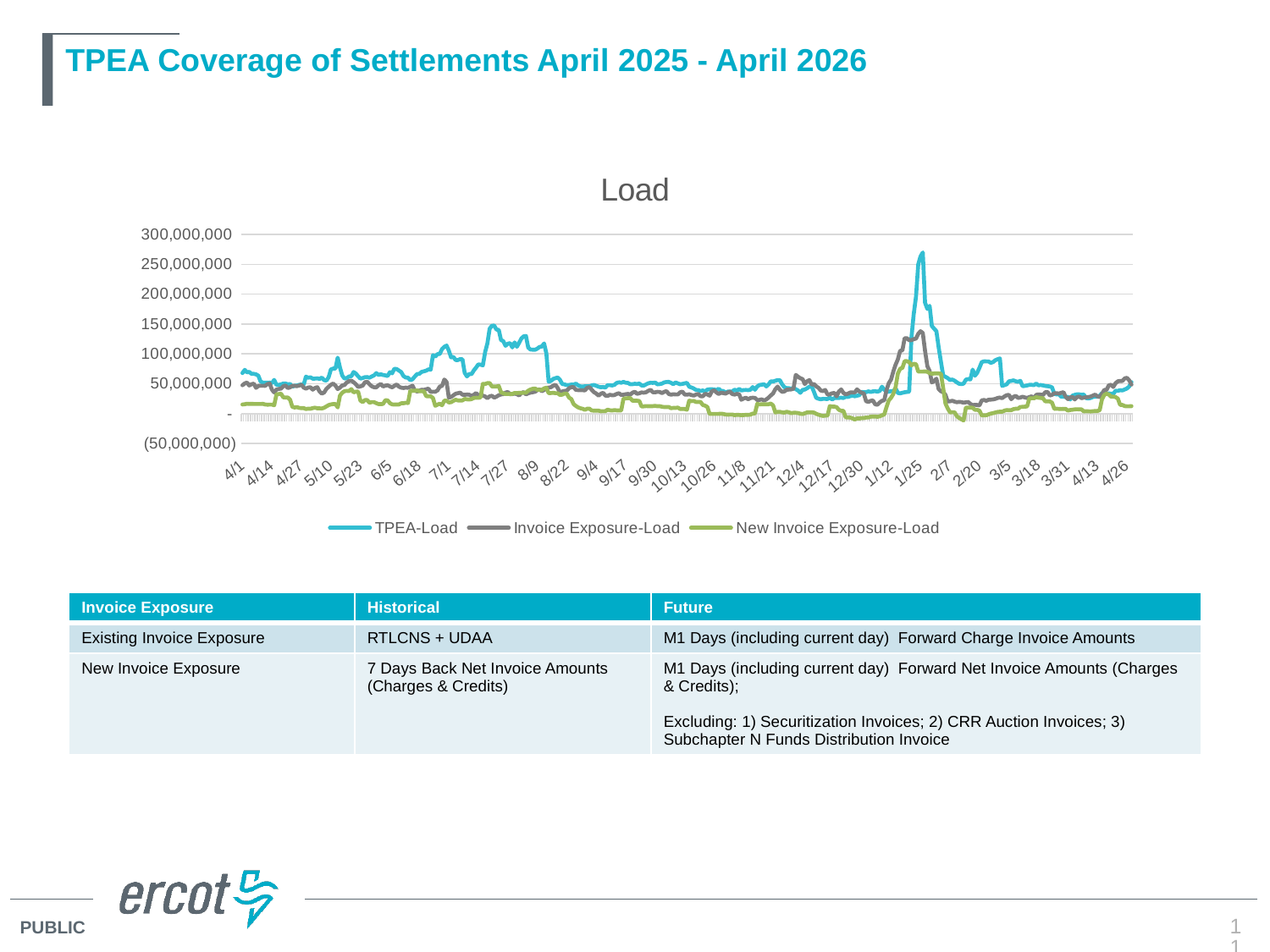
Is the value of TPEA-Load around 7/27 greater or less than 100,000,000? greater What is the lowest value shown on the y axis of the Load chart? (50,000,000) Which series in the Load chart is drawn in green? New Invoice Exposure-Load Around 7/27, which series is larger: TPEA-Load or Invoice Exposure-Load? TPEA-Load Is the peak value of TPEA-Load around 1/25 greater or less than 200,000,000? greater Around 1/25, which series is larger: Invoice Exposure-Load or New Invoice Exposure-Load? Invoice Exposure-Load What kind of chart is shown on the slide? line chart What is the highest value shown on the y axis of the Load chart? 300,000,000 What is the title of the chart on the slide? Load Which series in the Load chart reaches the highest value over the whole period? TPEA-Load Is the value of New Invoice Exposure-Load around 10/26 greater or less than 50,000,000? less How many series does the legend of the Load chart list? 3